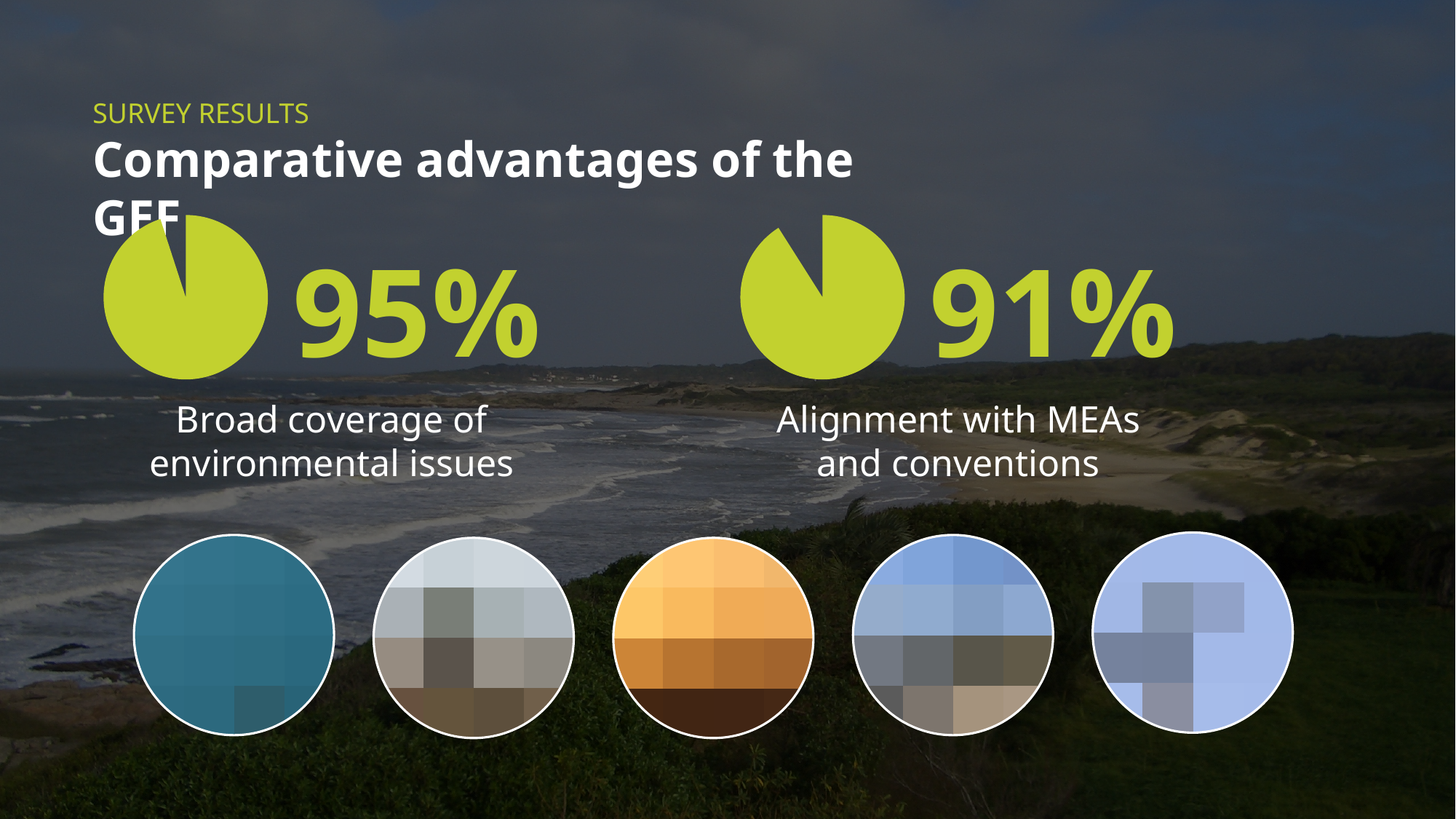
What percentage is shown for 'Alignment with MEAs and conventions'? 91% How many pie charts are shown on the slide? 2 What kind of chart is used to show the 95% and 91% survey results? Pie chart What is the title of the slide containing the pie charts? Comparative advantages of the GEF What colour are the filled portions of the pie charts? Green (lime/yellow-green) Which of the two survey results is higher: 'Broad coverage of environmental issues' or 'Alignment with MEAs and conventions'? Broad coverage of environmental issues What share of the left pie chart is filled in? 95% What percentage is shown for 'Broad coverage of environmental issues'? 95% What share of the right pie chart is filled in? 91% Is the value for 'Alignment with MEAs and conventions' greater or less than 90%? greater Which survey result shown on the slide has the lowest percentage? Alignment with MEAs and conventions What is the difference in percentage points between the 'Broad coverage of environmental issues' result and the 'Alignment with MEAs and conventions' result? 4 percentage points